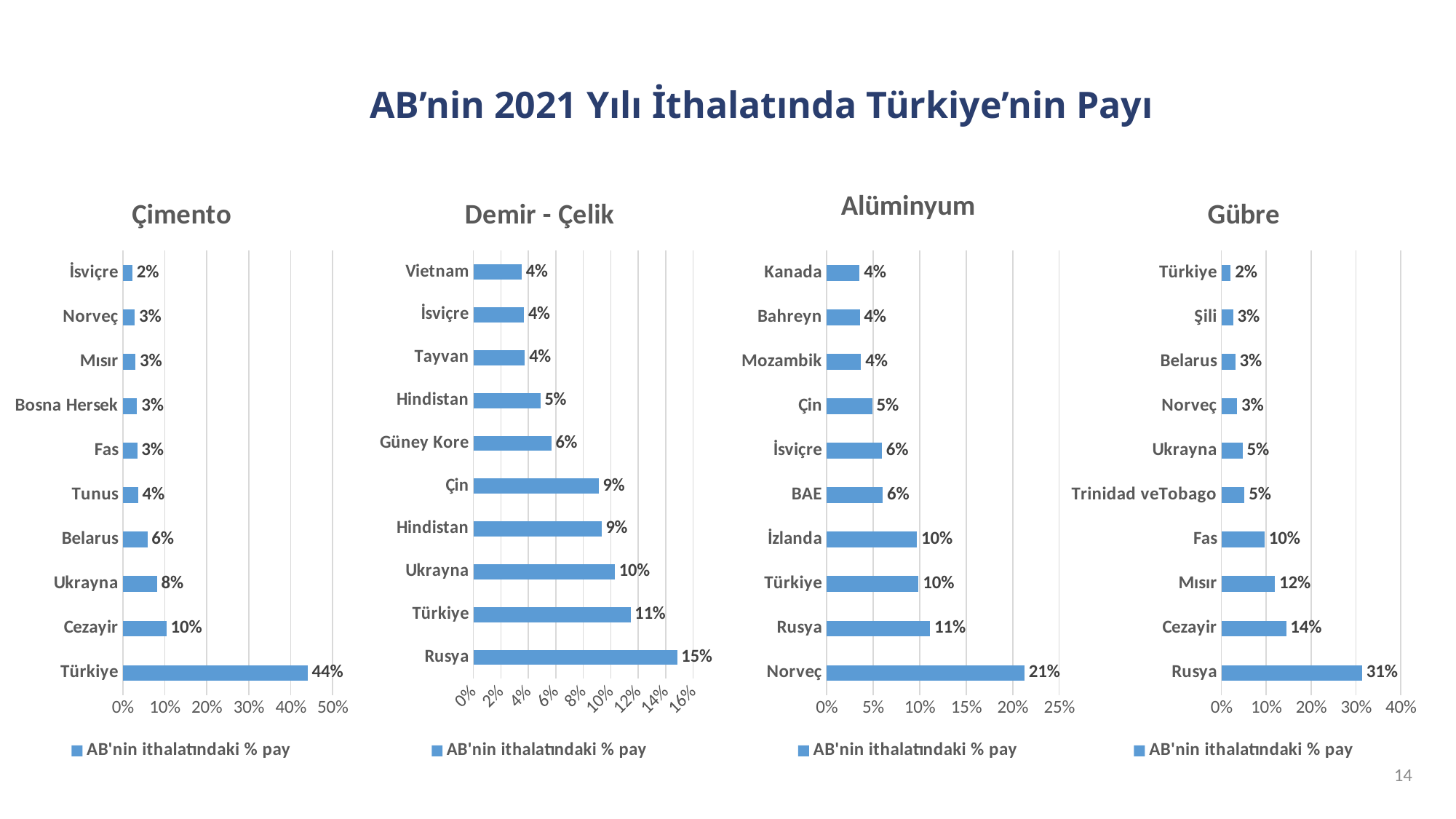
In the Alüminyum chart, which country has the highest value? Norveç How many countries are shown in the Gübre chart? 10 How many series does the legend of the Alüminyum chart list? 1 In the Alüminyum chart, what is the value for Türkiye? 10% In the Gübre chart, what is the value for Cezayir? 14% In the Çimento chart, what is the value for Türkiye? 44% In the Çimento chart, which country has the lowest value? İsviçre In the Gübre chart, which is larger, Mısır or Fas? Mısır In the Demir - Çelik chart, what is the difference between Rusya and Türkiye? 4% What kind of chart is the Çimento chart? Bar chart In the Gübre chart, what is the difference between Rusya and Cezayir? 17% In the Demir - Çelik chart, what is the value for Rusya? 15%